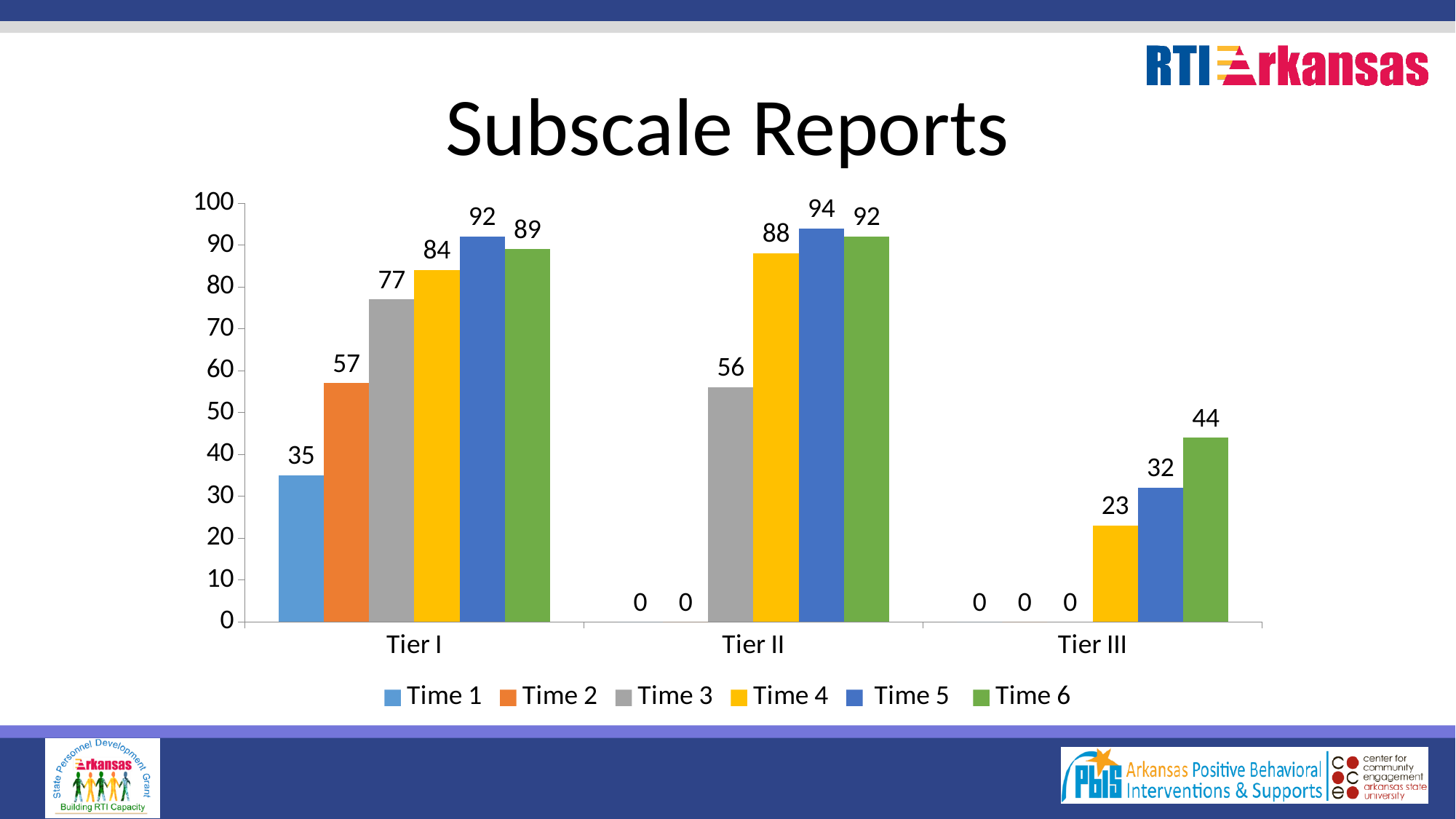
Which time period has the highest value for Tier II? Time 5 Which is larger for Time 6: the Tier I value or the Tier II value? Tier II Which time period has the lowest non-zero value for Tier I? Time 1 How many tier categories are shown on the x axis? 3 Do the Tier III values rise or fall from Time 4 to Time 6? Rise What is the title of the slide? Subscale Reports What is the Time 4 value for Tier II? 88 What kind of chart is shown on the slide? Bar chart What is the Time 6 value for Tier III? 44 What is the Time 1 value for Tier I? 35 How many series does the legend list? 6 What is the difference between the Time 5 and Time 1 values for Tier I? 57